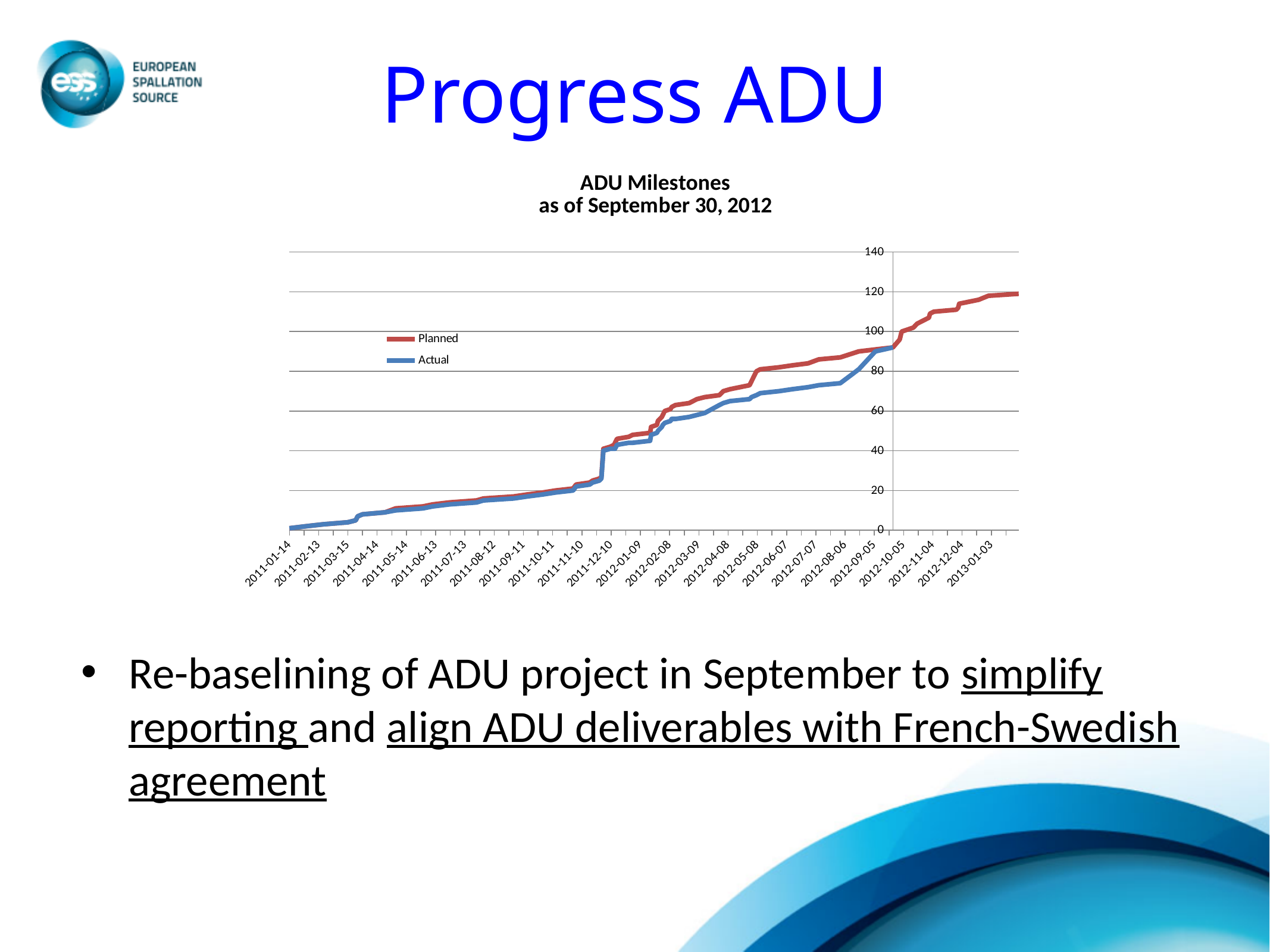
Is the Planned value at 2012-05-08 greater or less than 60? greater What is the title of the chart on the slide? ADU Milestones as of September 30, 2012 Do the Planned values rise or fall along the x axis of the ADU Milestones chart? rise Is the Planned value at 2012-10-05 greater or less than 80? greater What kind of chart is shown on the slide? line chart Is the Actual value at 2012-08-06 greater or less than 80? less Do the Actual values rise or fall along the x axis of the ADU Milestones chart? rise Which series extends further along the x axis, Planned or Actual? Planned At 2012-08-06, which series has the larger value, Planned or Actual? Planned How many series does the legend of the ADU Milestones chart list? 2 What are the two series named in the legend of the ADU Milestones chart? Planned and Actual